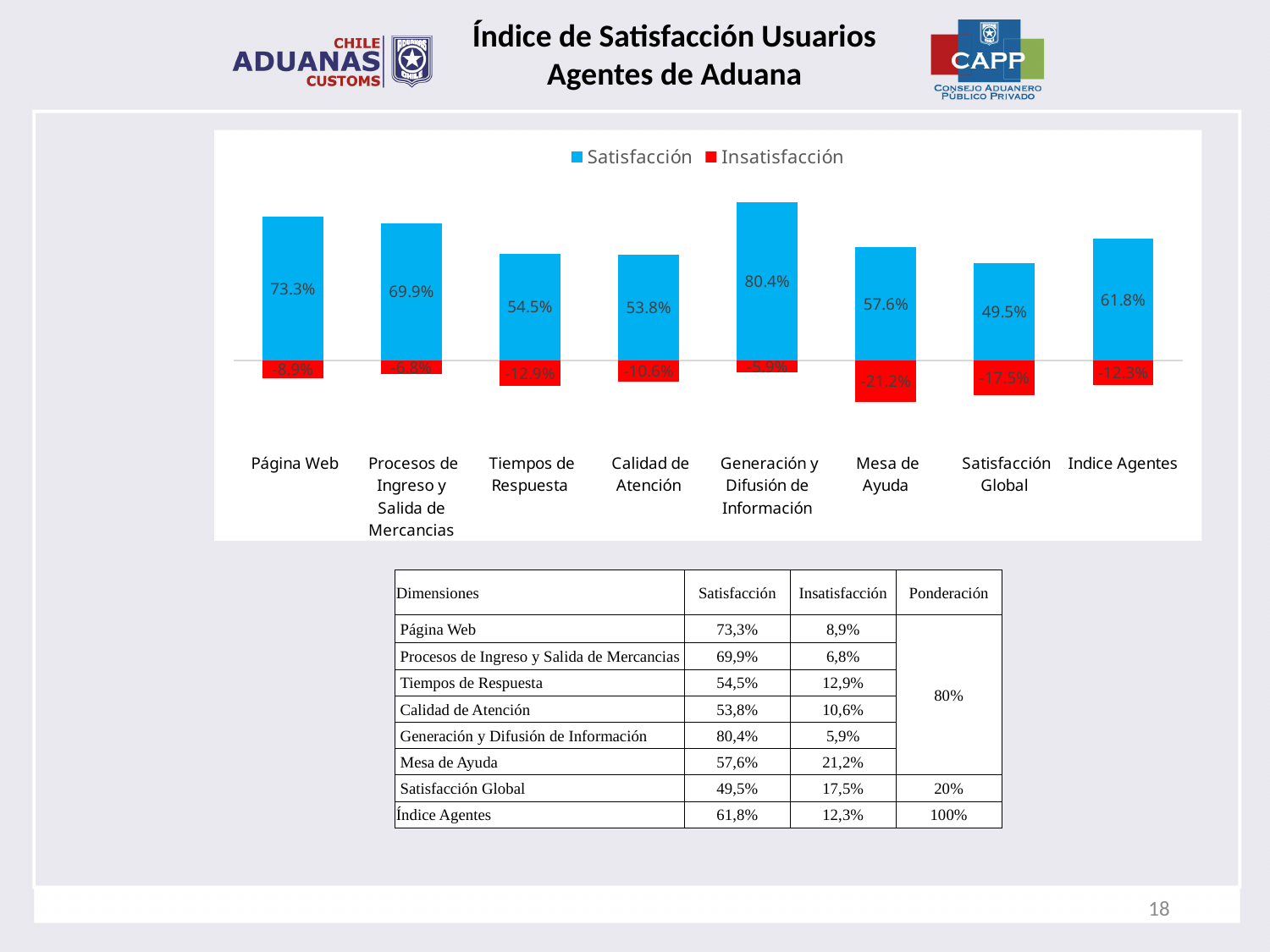
How many series does the chart legend list? 2 Which category has the lowest Satisfacción value? Satisfacción Global Which colour represents the Insatisfacción series in the chart? Red Which is larger, the Satisfacción value for Tiempos de Respuesta or for Calidad de Atención? Tiempos de Respuesta What is the Satisfacción value for Indice Agentes? 61.8% What is the Satisfacción value for Página Web? 73.3% What is the Satisfacción value for Generación y Difusión de Información? 80.4% What is the difference between the Satisfacción values for Página Web and Procesos de Ingreso y Salida de Mercancias? 3.4% What is the Insatisfacción value shown for Mesa de Ayuda? -21.2% What kind of chart is shown on the slide? Bar chart How many categories are shown on the x axis of the chart? 8 Which category has the highest Satisfacción value? Generación y Difusión de Información